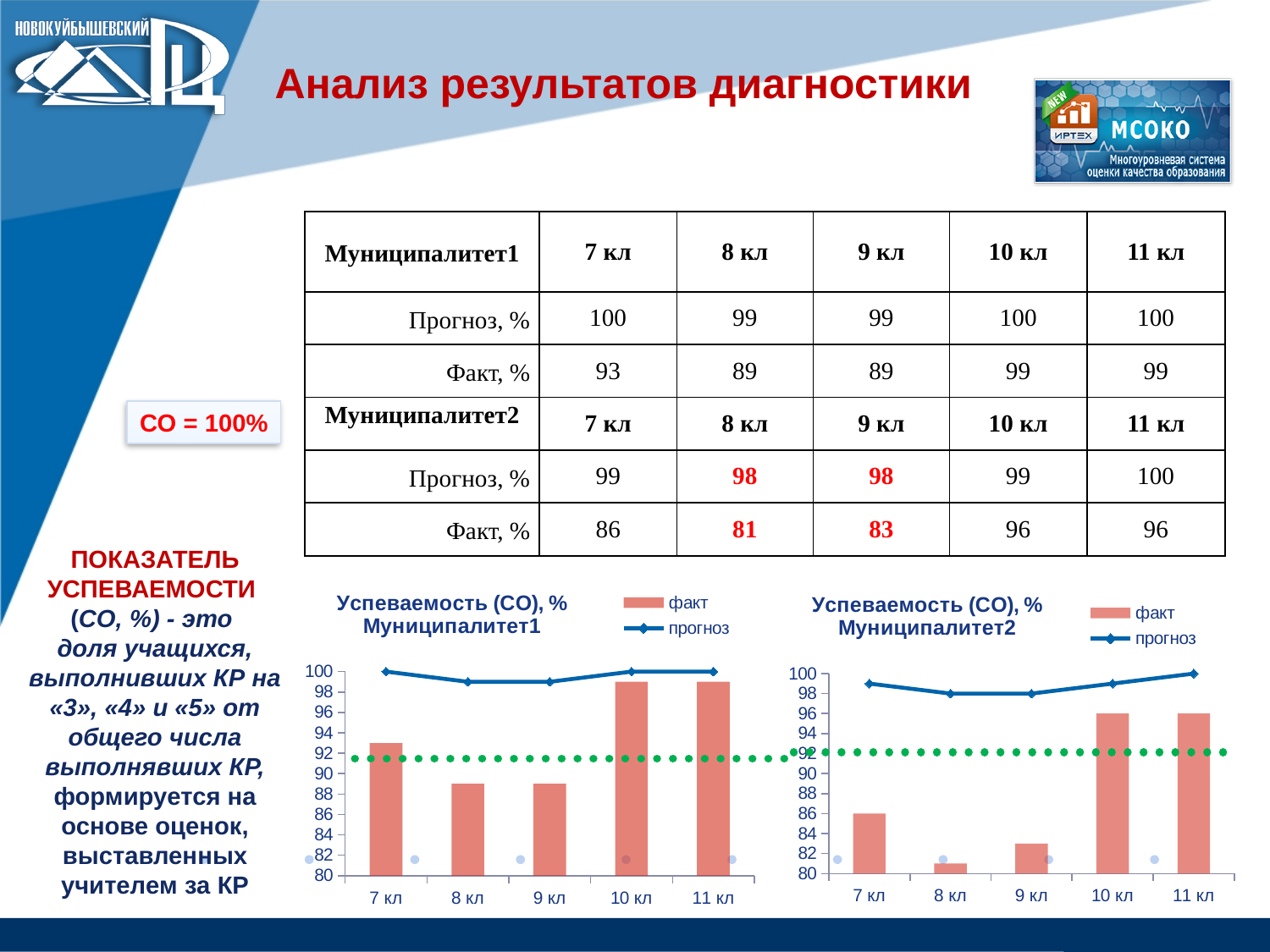
What kind of chart is the "Успеваемость (СО), % Муниципалитет1" chart? bar chart with a line In the "Успеваемость (СО), % Муниципалитет2" chart, what is the difference between the факт values for 10 кл and 7 кл? 10 In the "Успеваемость (СО), % Муниципалитет2" chart, what is the факт value for 7 кл? 86 In the "Успеваемость (СО), % Муниципалитет1" chart, what is the прогноз value for 7 кл? 100 In the "Успеваемость (СО), % Муниципалитет1" chart, is the факт value for 7 кл greater or less than 90? greater How many series does the legend of the "Успеваемость (СО), % Муниципалитет2" chart list? 2 How many categories are shown on the x axis of the "Успеваемость (СО), % Муниципалитет1" chart? 5 In the "Успеваемость (СО), % Муниципалитет2" chart, which category has the lowest факт bar? 8 кл In the "Успеваемость (СО), % Муниципалитет1" chart, is the факт value for 8 кл greater or less than 92? less What are the two legend entries in the "Успеваемость (СО), % Муниципалитет2" chart? факт and прогноз In the "Успеваемость (СО), % Муниципалитет1" chart, which has the larger факт value, 7 кл or 8 кл? 7 кл In the "Успеваемость (СО), % Муниципалитет2" chart, what is the факт value for 10 кл? 96